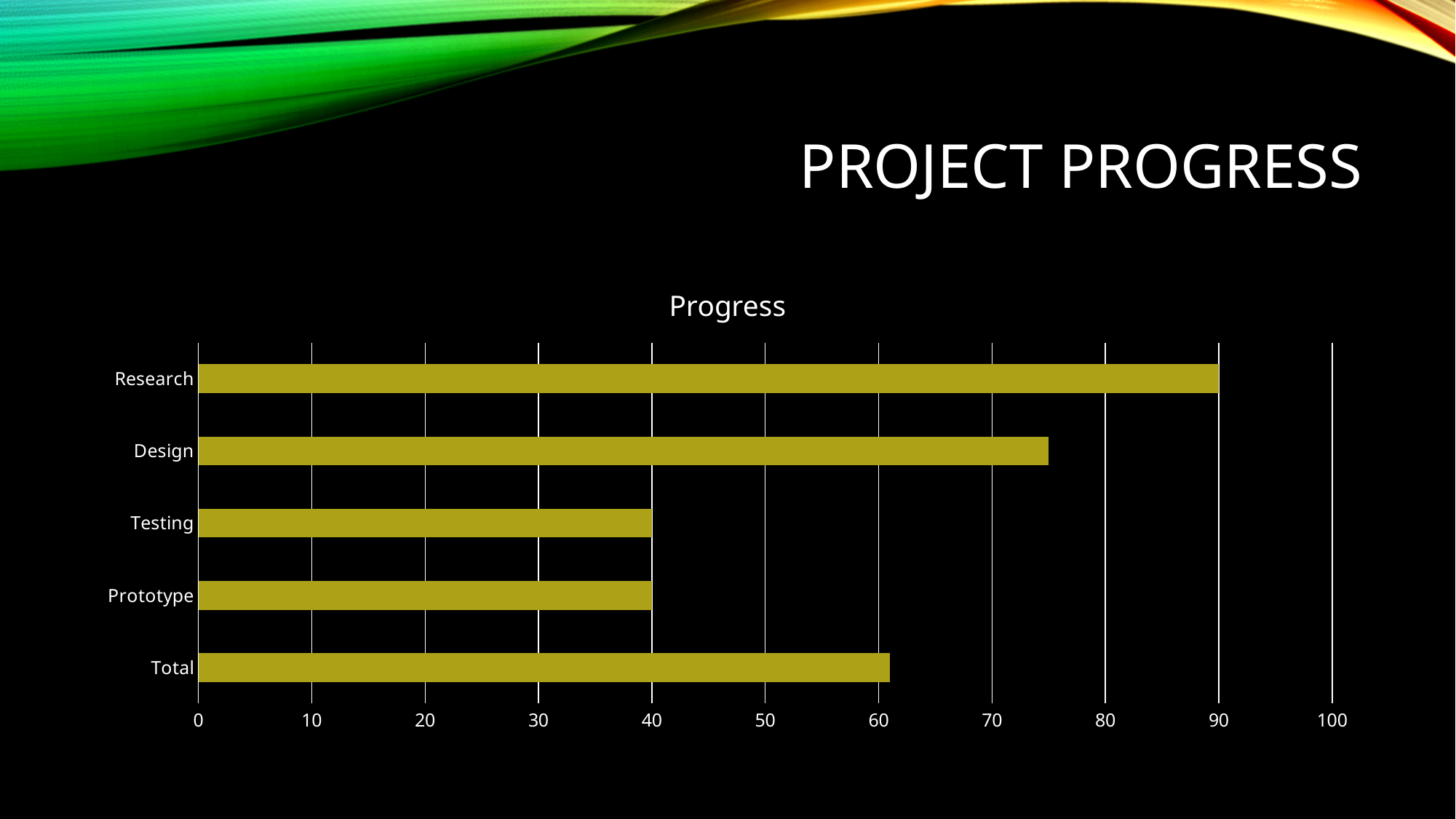
What is the value for Prototype? 40 Is the value for Total greater or less than 50? greater Is the value for Design greater or less than 70? greater What kind of chart is shown on the slide? Bar chart Which is larger, the value for Research or the value for Design? Research Which category has the highest value? Research What is the value for Testing? 40 What is the difference between the values for Research and Testing? 50 Which is larger, the value for Total or the value for Design? Design What is the value for Research? 90 How many categories are plotted in the chart? 5 What is the title of the chart? Progress